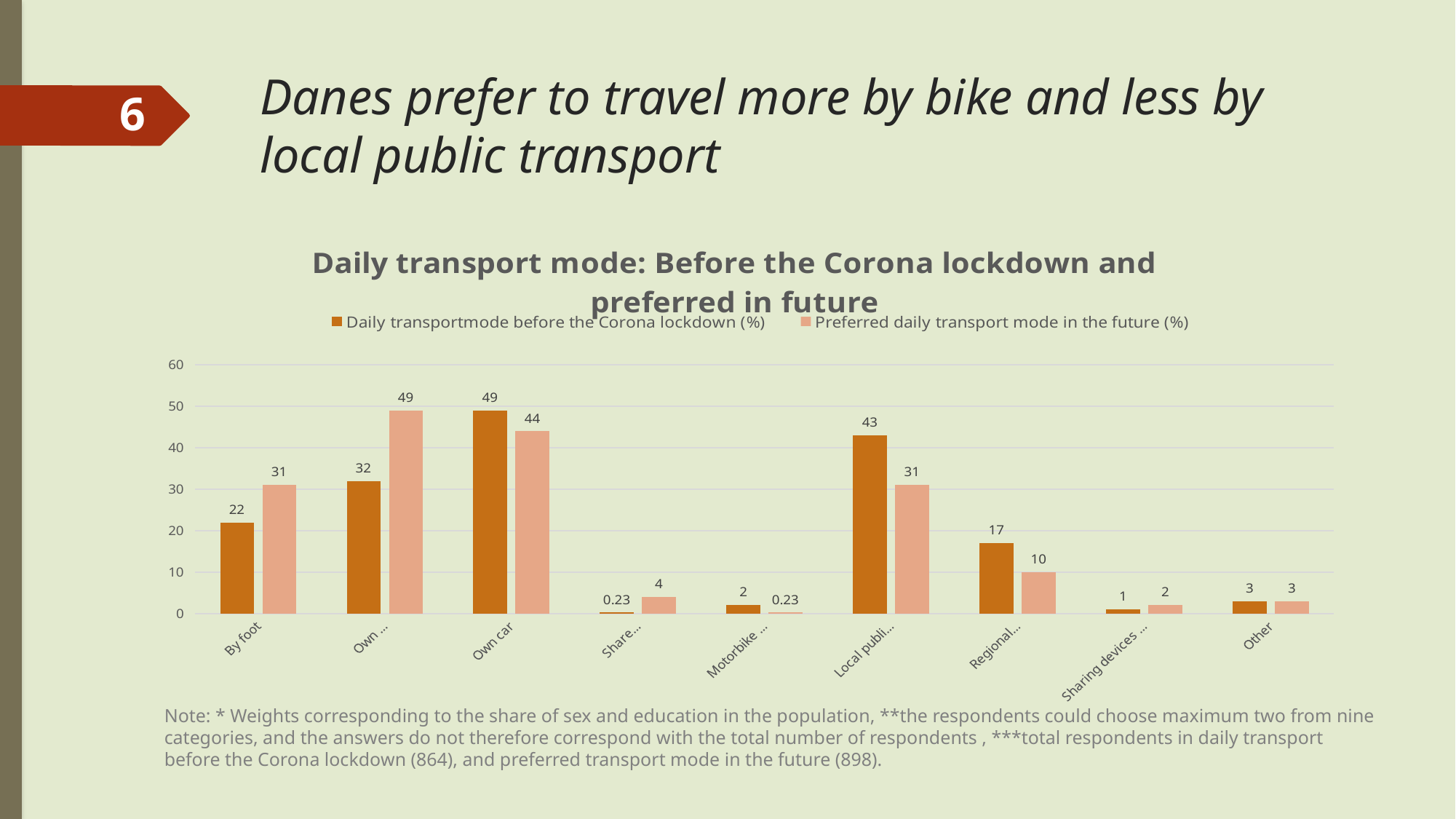
For By foot, how much higher is the preferred-future value than the before-lockdown value? 9 What is the value for By foot in the 'Daily transportmode before the Corona lockdown (%)' series? 22 For By foot, which series has the larger value: before the Corona lockdown or preferred in the future? Preferred daily transport mode in the future (%) What kind of chart is shown on the slide? Bar chart What is the value for By foot in the 'Preferred daily transport mode in the future (%)' series? 31 What is the value for Other in the 'Preferred daily transport mode in the future (%)' series? 3 Which category has the highest value in the 'Daily transportmode before the Corona lockdown (%)' series? Own car What is the value for Own car in the 'Daily transportmode before the Corona lockdown (%)' series? 49 What is the value for Own car in the 'Preferred daily transport mode in the future (%)' series? 44 How many series does the chart's legend list? 2 How many categories are shown on the x axis of the chart? 9 For Own car, how much higher is the before-lockdown value than the preferred-future value? 5